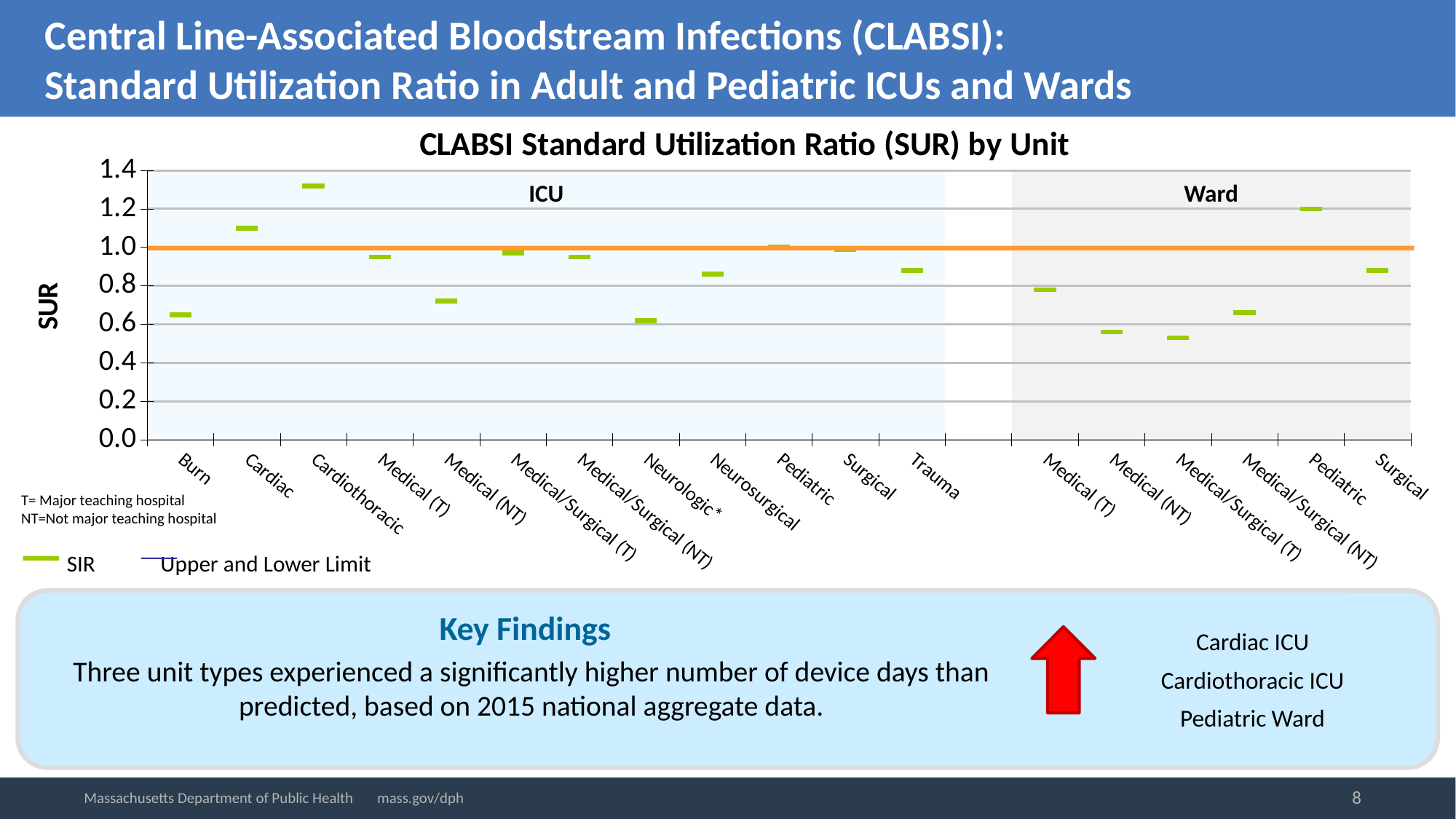
What is the title of the chart? CLABSI Standard Utilization Ratio (SUR) by Unit How many unit categories are plotted in the Ward section of the chart? 6 Is the SUR value for the Burn ICU greater or less than 0.8? less Is the SUR value for the Cardiothoracic ICU greater or less than 1.2? greater Which unit has the highest SUR value on the chart? Cardiothoracic (ICU) How many unit categories are plotted in the ICU section of the chart? 12 Is the SUR value for the Pediatric Ward greater or less than 1.0? greater What is the label on the vertical axis of the chart? SUR Which has the higher SUR value: the Cardiac ICU or the Burn ICU? Cardiac ICU Which has the higher SUR value: the Pediatric Ward or the Medical (NT) Ward? Pediatric Ward How many unit categories are plotted along the x axis in total? 18